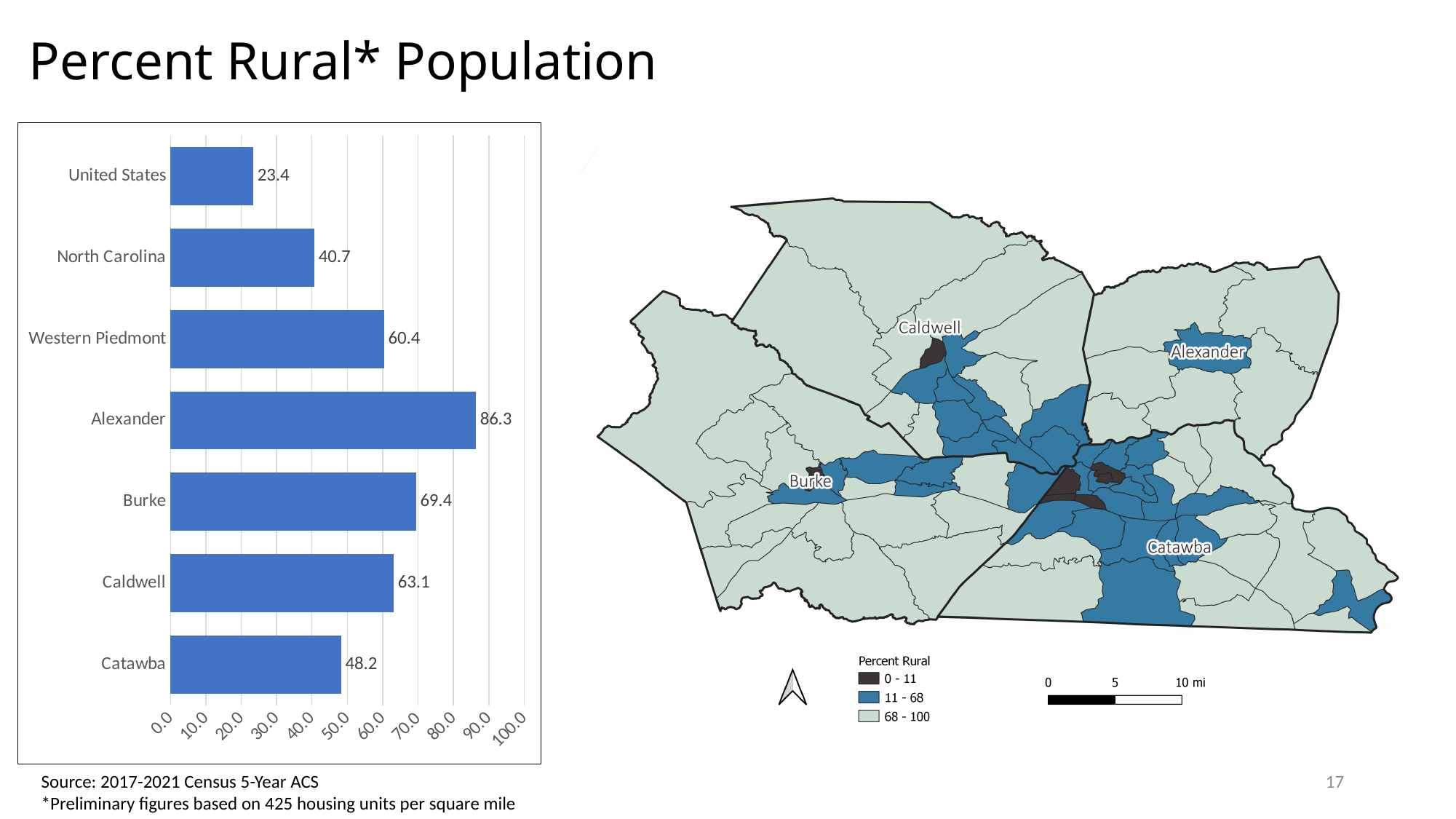
What is the difference between the percent rural population of Burke and Caldwell? 6.3 What is the percent rural population for Alexander? 86.3 Which category has the lowest percent rural population? United States Which has a larger percent rural population, Western Piedmont or North Carolina? Western Piedmont What is the title of the slide? Percent Rural* Population What is the difference between the percent rural population of Alexander and the United States? 62.9 What is the percent rural population for Catawba? 48.2 Is the value for Caldwell greater or less than 60.0? greater What kind of chart is shown on the left of the slide? bar chart What is the percent rural population for the United States? 23.4 Which category has the highest percent rural population? Alexander How many categories are shown in the bar chart? 7